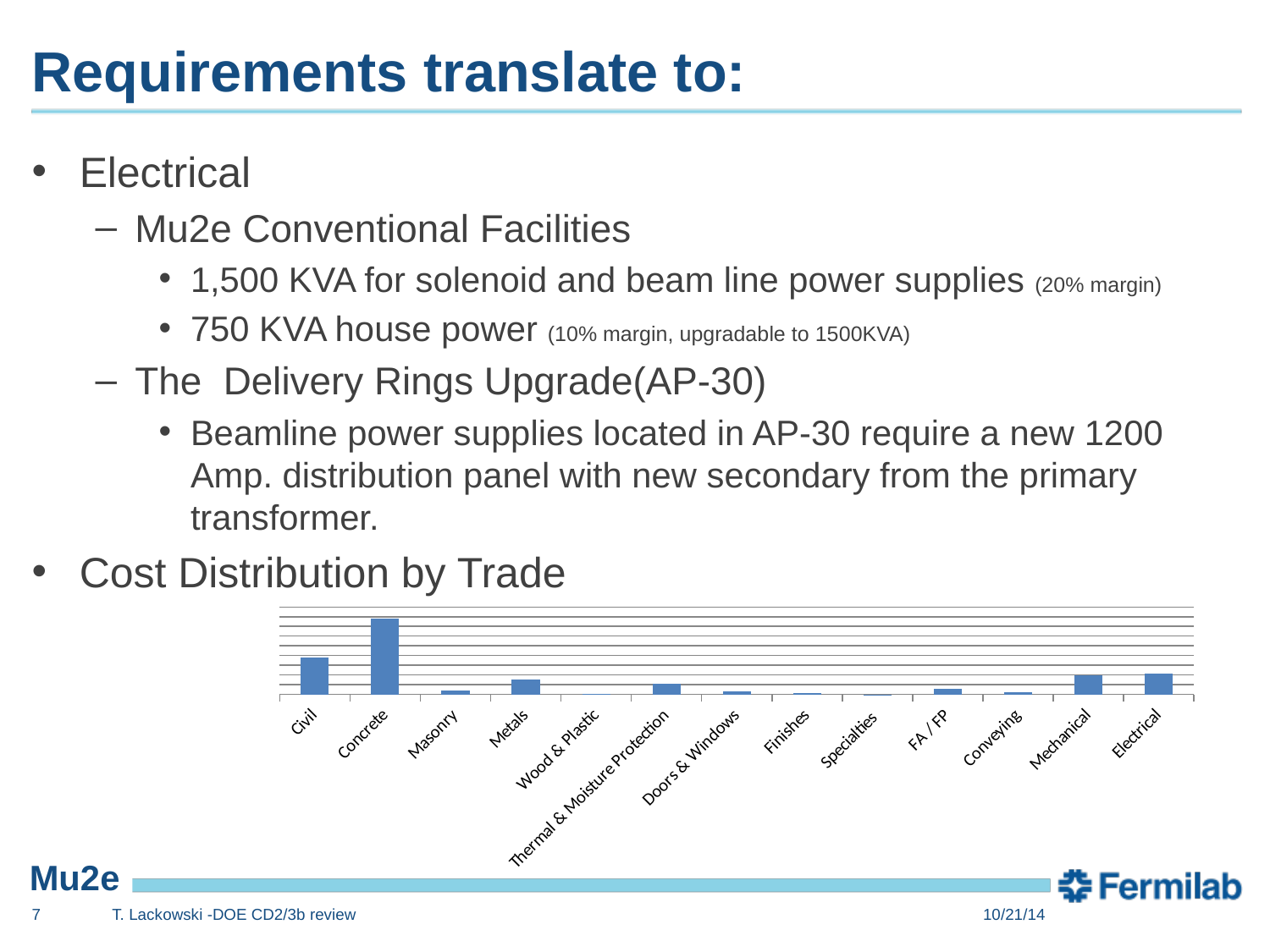
In the Cost Distribution by Trade chart, which is larger, Metals or Finishes? Metals In the Cost Distribution by Trade chart, which is larger, Civil or Concrete? Concrete In the Cost Distribution by Trade chart, which is larger, Electrical or Masonry? Electrical What is the first category on the x axis of the Cost Distribution by Trade chart? Civil What kind of chart is shown under "Cost Distribution by Trade"? bar chart How many trade categories are shown on the x axis of the Cost Distribution by Trade chart? 13 Which trade has the highest bar in the Cost Distribution by Trade chart? Concrete What is the last category on the x axis of the Cost Distribution by Trade chart? Electrical